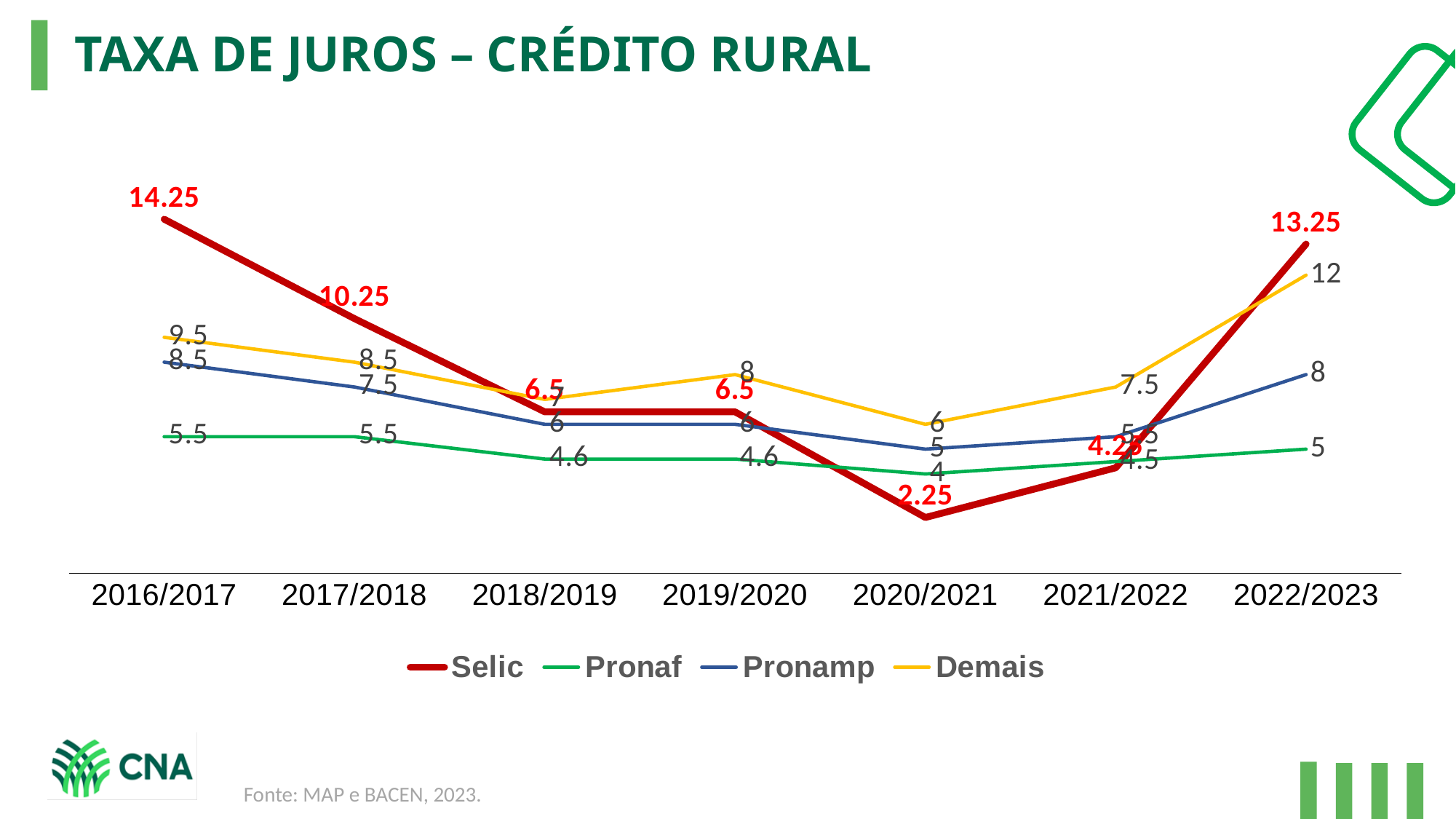
How many periods are shown on the x axis? 7 Does the Selic line rise or fall from 2016/2017 to 2020/2021? fall What is the Pronaf value for 2020/2021? 4 What kind of chart is shown on the slide? line chart In 2016/2017, which is higher: Demais or Pronamp? Demais In which period is the Selic rate lowest? 2020/2021 What is the Demais value for 2022/2023? 12 What is the difference between the Selic value in 2016/2017 and in 2022/2023? 1 What is the Selic value for 2016/2017? 14.25 How many series does the legend list? 4 What is the Selic value for 2020/2021? 2.25 In which period is the Selic rate highest? 2016/2017